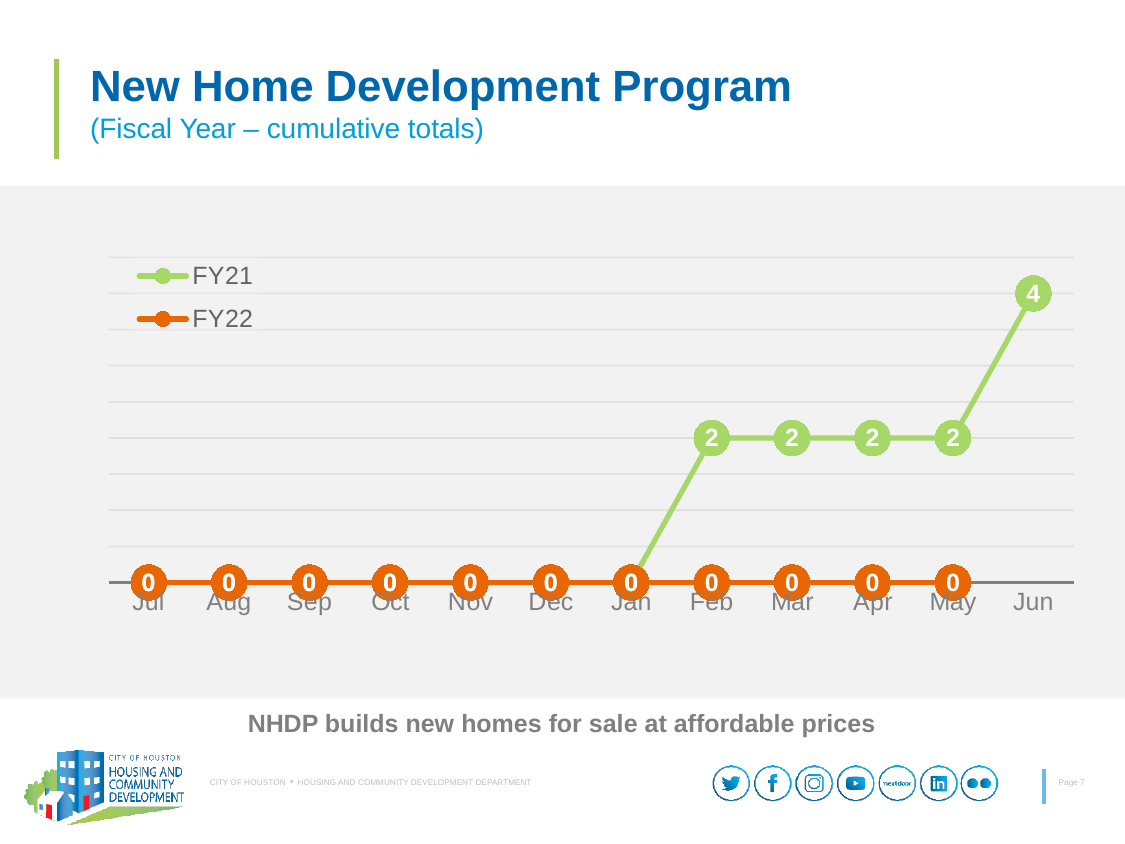
What kind of chart is shown on the slide? line chart What is the FY22 value for May? 0 What is the FY21 value for Feb? 2 Which is larger: the FY21 value for Jun or the FY21 value for Feb? Jun What is the FY22 value for Jan? 0 Does the FY21 series rise or fall from Jan to Jun? rise In which month does the FY21 series reach its highest value? Jun How many series does the legend list? 2 How many months are shown on the x axis? 12 What is the FY21 value for Jun? 4 What is the difference between the FY21 value for Jun and the FY21 value for May? 2 What are the two series named in the legend? FY21 and FY22